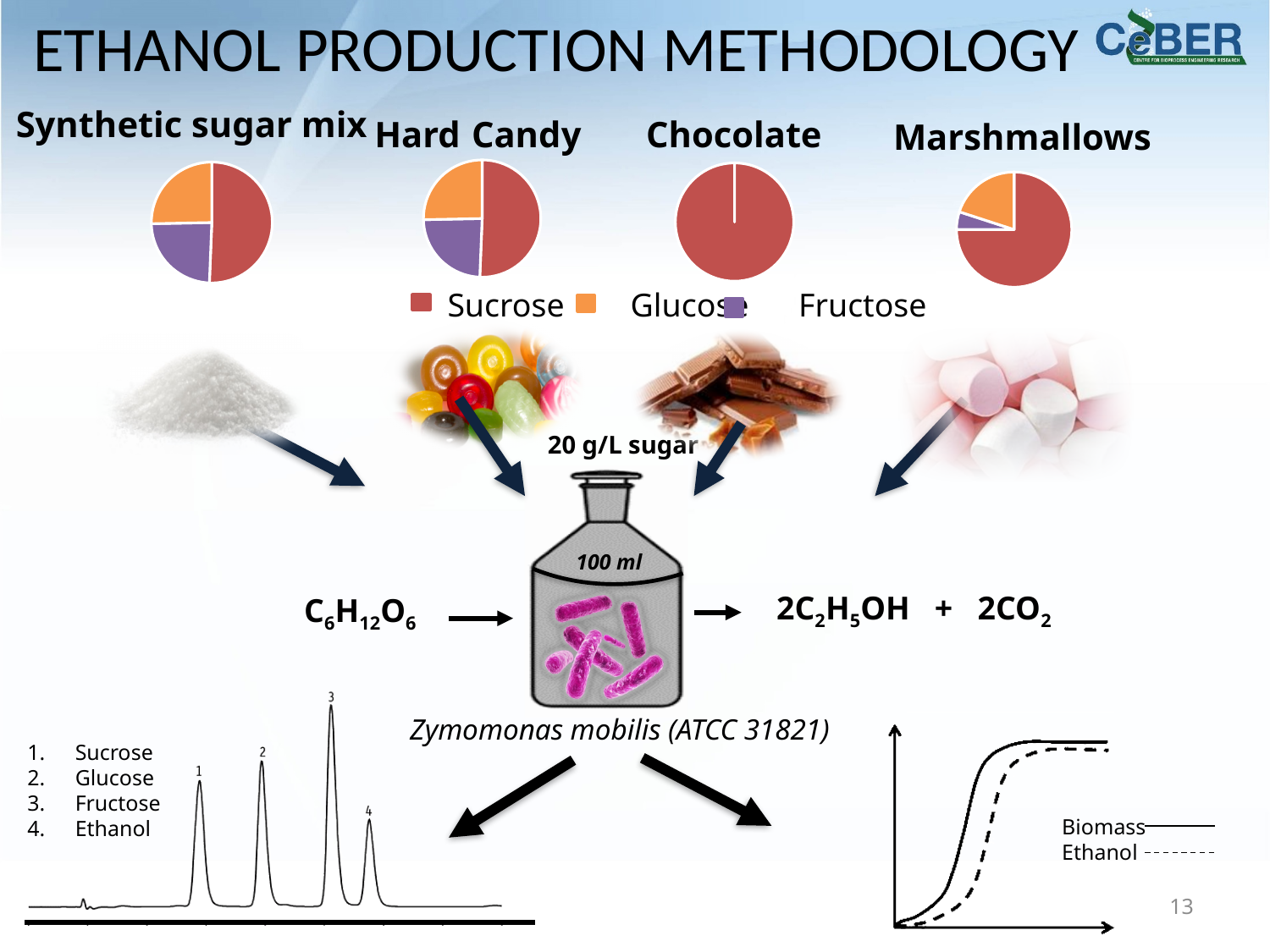
In the Marshmallows pie chart, which sugar has the largest slice? Sucrose How many pie charts are shown on the slide? 4 In the Hard Candy pie chart, which slice is larger, Sucrose or Glucose? Sucrose Which of the four pie charts is made up almost entirely of Sucrose? Chocolate What kind of chart is the Hard Candy chart? pie chart In the Marshmallows pie chart, which sugar has the smallest slice? Fructose In the pie chart legend, which colour represents Sucrose? red In the Synthetic sugar mix pie chart, which sugar has the largest slice? Sucrose In the Chocolate pie chart, which sugar has the largest slice? Sucrose How many entries does the shared legend for the sugar composition pie charts list? 3 In the Marshmallows pie chart, which slice is larger, Glucose or Fructose? Glucose